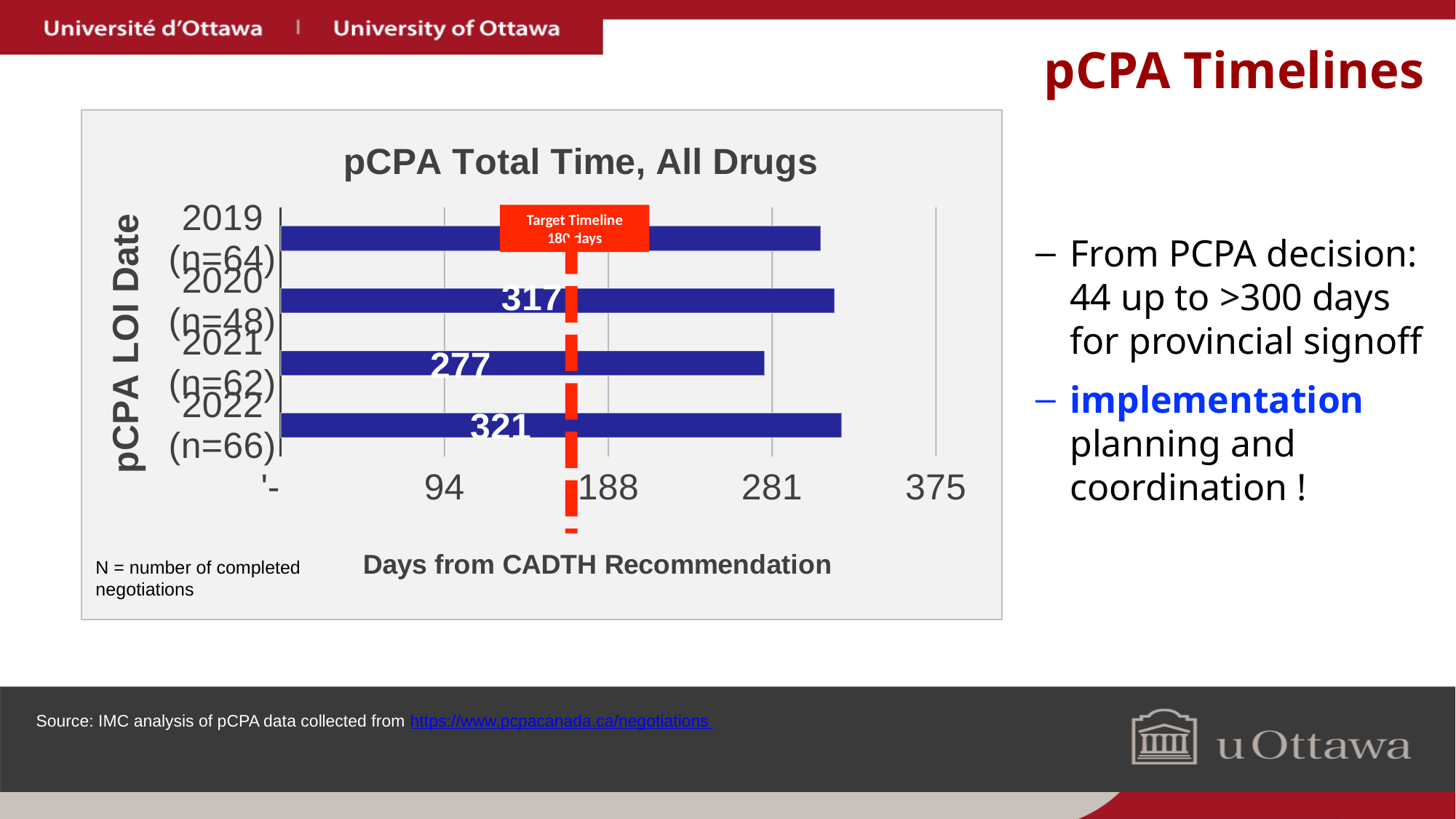
What target timeline, in days, is marked by the red dashed line in the pCPA Total Time, All Drugs chart? 180 days What is the value for 2021 (n=62) in the pCPA Total Time, All Drugs chart? 277 How many years (categories) are shown in the pCPA Total Time, All Drugs chart? 4 Which year has the highest value in the pCPA Total Time, All Drugs chart? 2022 (n=66) What is the value for 2022 (n=66) in the pCPA Total Time, All Drugs chart? 321 Is the value for 2021 (n=62) greater or less than 188 in the pCPA Total Time, All Drugs chart? greater What kind of chart is the pCPA Total Time, All Drugs chart? bar chart What is the difference between the values for 2022 (n=66) and 2021 (n=62) in the pCPA Total Time, All Drugs chart? 44 Is the value for 2019 (n=64) greater or less than 281 in the pCPA Total Time, All Drugs chart? greater What is the difference between the values for 2020 (n=48) and 2021 (n=62) in the pCPA Total Time, All Drugs chart? 40 What is the value for 2020 (n=48) in the pCPA Total Time, All Drugs chart? 317 Which year has the lowest value in the pCPA Total Time, All Drugs chart? 2021 (n=62)